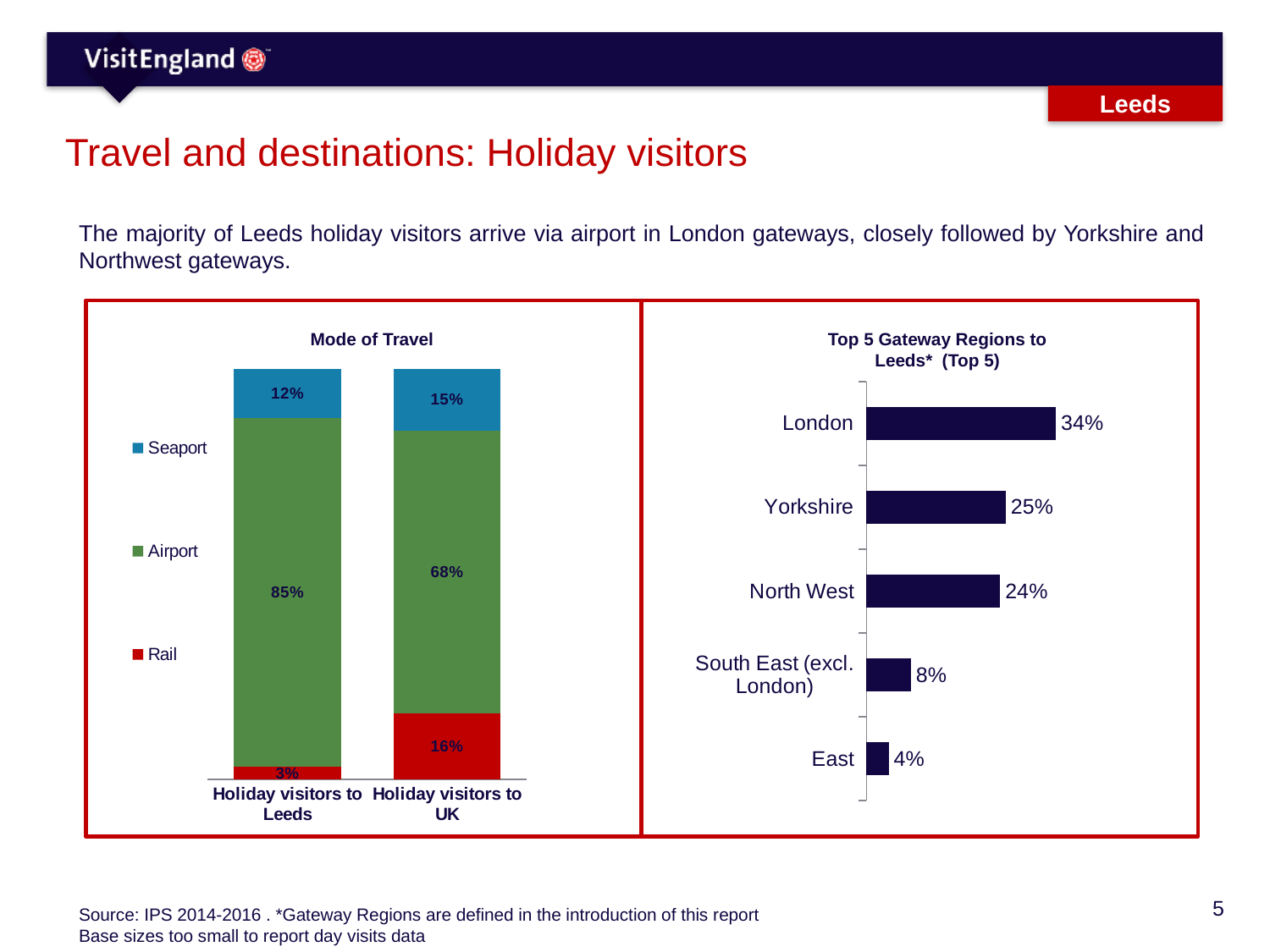
In the 'Mode of Travel' chart, what percentage of holiday visitors to the UK arrive by rail? 16% In the 'Top 5 Gateway Regions to Leeds' chart, what is the difference between London and North West? 10 percentage points In the 'Mode of Travel' chart, what is the difference between the airport share for holiday visitors to Leeds and for holiday visitors to the UK? 17 percentage points In the 'Top 5 Gateway Regions to Leeds' chart, how many regions are shown? 5 In the 'Mode of Travel' chart, what is the seaport share for holiday visitors to Leeds? 12% What kind of chart is the 'Top 5 Gateway Regions to Leeds' chart? Bar chart In the 'Top 5 Gateway Regions to Leeds' chart, which region has the lowest value? East In the 'Top 5 Gateway Regions to Leeds' chart, what is the value for Yorkshire? 25% In the 'Mode of Travel' chart, which is larger: the rail share for holiday visitors to Leeds or for holiday visitors to the UK? Holiday visitors to UK In the 'Mode of Travel' chart, what percentage of holiday visitors to Leeds arrive by airport? 85% In the 'Mode of Travel' chart, how many series does the legend list? 3 In the 'Top 5 Gateway Regions to Leeds' chart, which region has the highest value? London